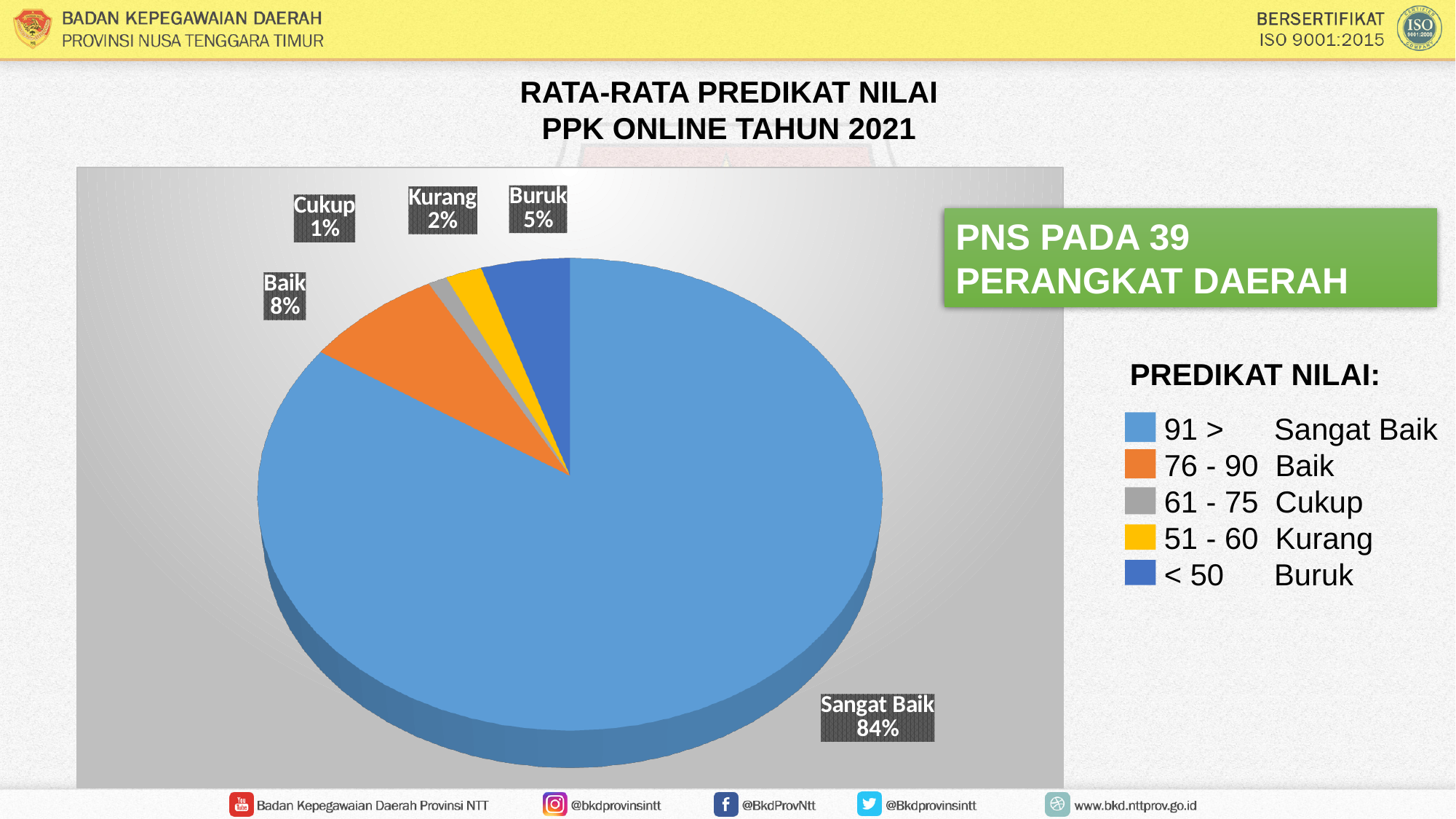
What is the difference in percentage points between Sangat Baik and Baik? 76 What is the title of the chart? RATA-RATA PREDIKAT NILAI PPK ONLINE TAHUN 2021 What is the value shown for Baik? 8% Which category has the smallest slice of the pie? Cukup What share of the pie does Sangat Baik have? 84% Which category has the largest slice of the pie? Sangat Baik What kind of chart is shown on the slide? Pie chart What is the value shown for Buruk? 5% How many categories are shown in the pie chart? 5 What is the value shown for Cukup? 1% What is the value shown for Kurang? 2% Which is larger, the slice for Buruk or the slice for Kurang? Buruk